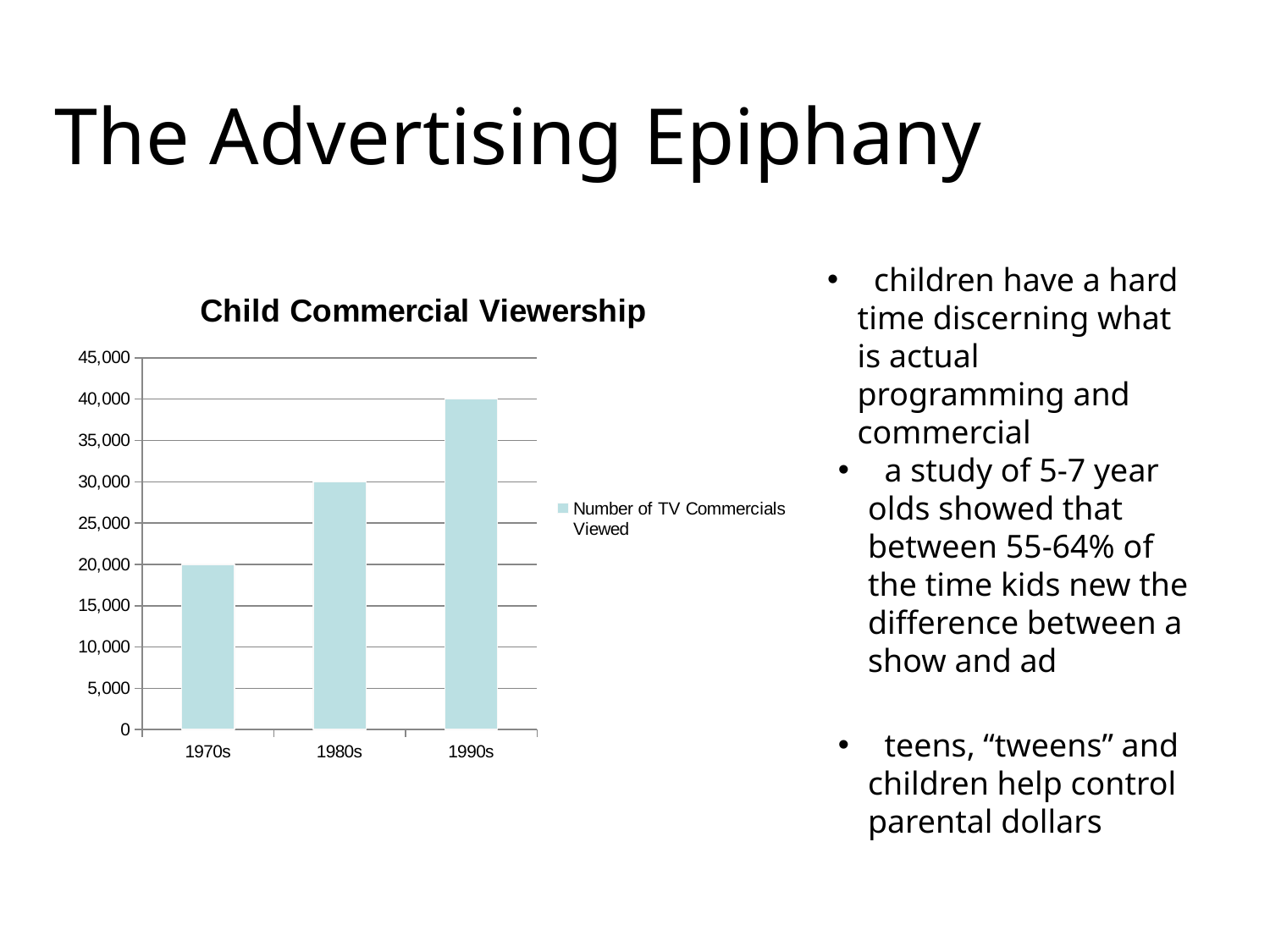
What is the difference between the values for the 1990s and the 1970s? 20,000 Is the value for the 1980s greater or less than 25,000? greater What is the value for the 1970s in the Child Commercial Viewership chart? 20,000 How many series does the chart legend list? 1 Which is larger, the value for the 1980s or the value for the 1970s? 1980s Which decade has the lowest number of TV commercials viewed? 1970s Which decade has the highest number of TV commercials viewed? 1990s Do the values rise or fall from the 1970s to the 1990s? rise What kind of chart is shown on the slide? bar chart What is the value for the 1980s in the Child Commercial Viewership chart? 30,000 What is the value for the 1990s in the Child Commercial Viewership chart? 40,000 How many decades are shown on the x axis of the chart? 3